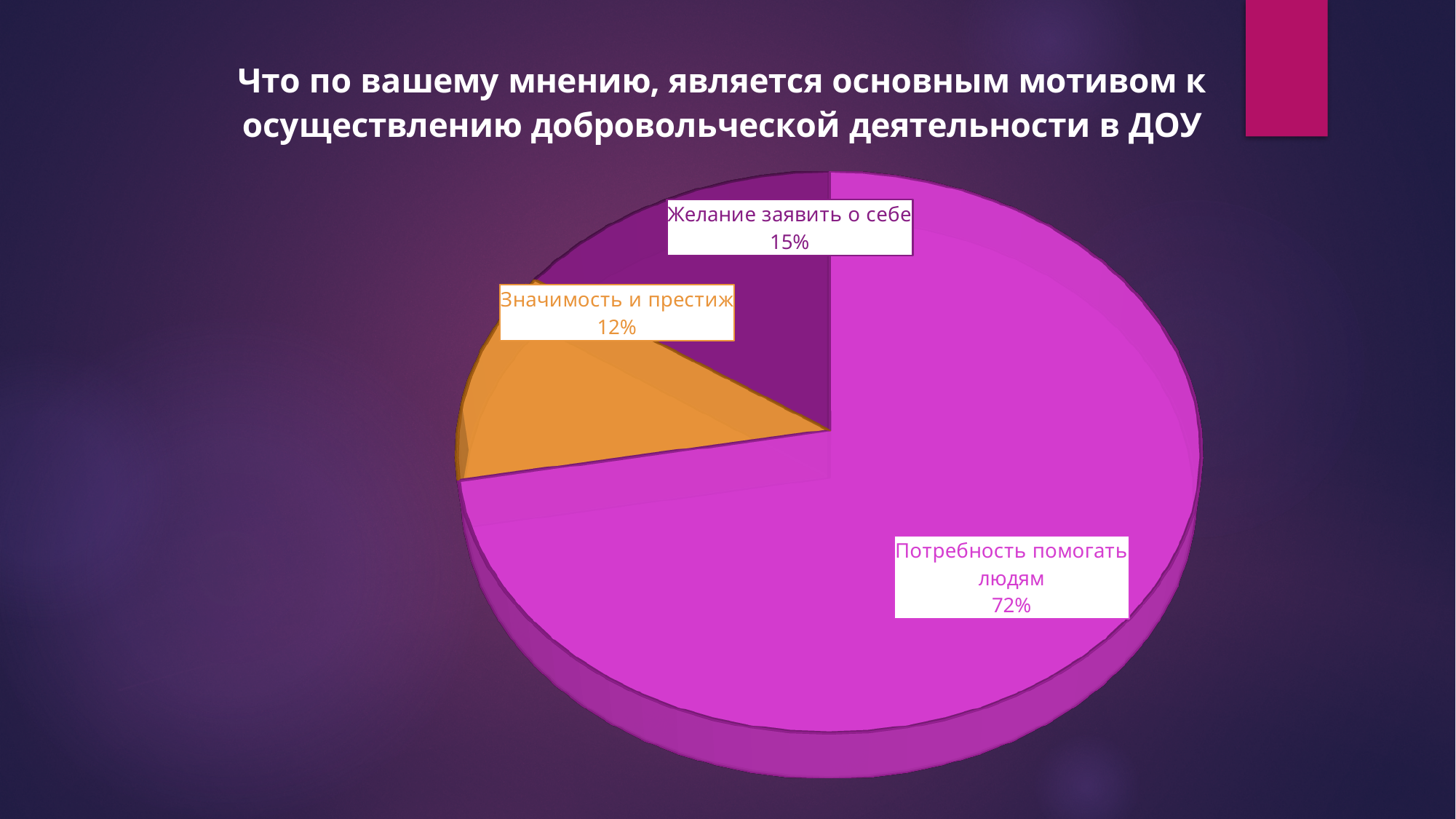
What is the difference in percentage points between "Желание заявить о себе" and "Значимость и престиж"? 3 Which category has the smallest slice of the pie? Значимость и престиж Which category has the largest slice of the pie? Потребность помогать людям What share of the pie does "Значимость и престиж" have? 12% What colour is the slice for "Значимость и престиж"? Orange Which is larger: the slice for "Желание заявить о себе" or the slice for "Значимость и престиж"? Желание заявить о себе What type of chart is shown on the slide? Pie chart What share of the pie does "Потребность помогать людям" have? 72% What share of the pie does "Желание заявить о себе" have? 15% What is the difference in percentage points between "Потребность помогать людям" and "Желание заявить о себе"? 57 How many slices does the pie chart have? 3 What is the title of the chart? Что по вашему мнению, является основным мотивом к осуществлению добровольческой деятельности в ДОУ